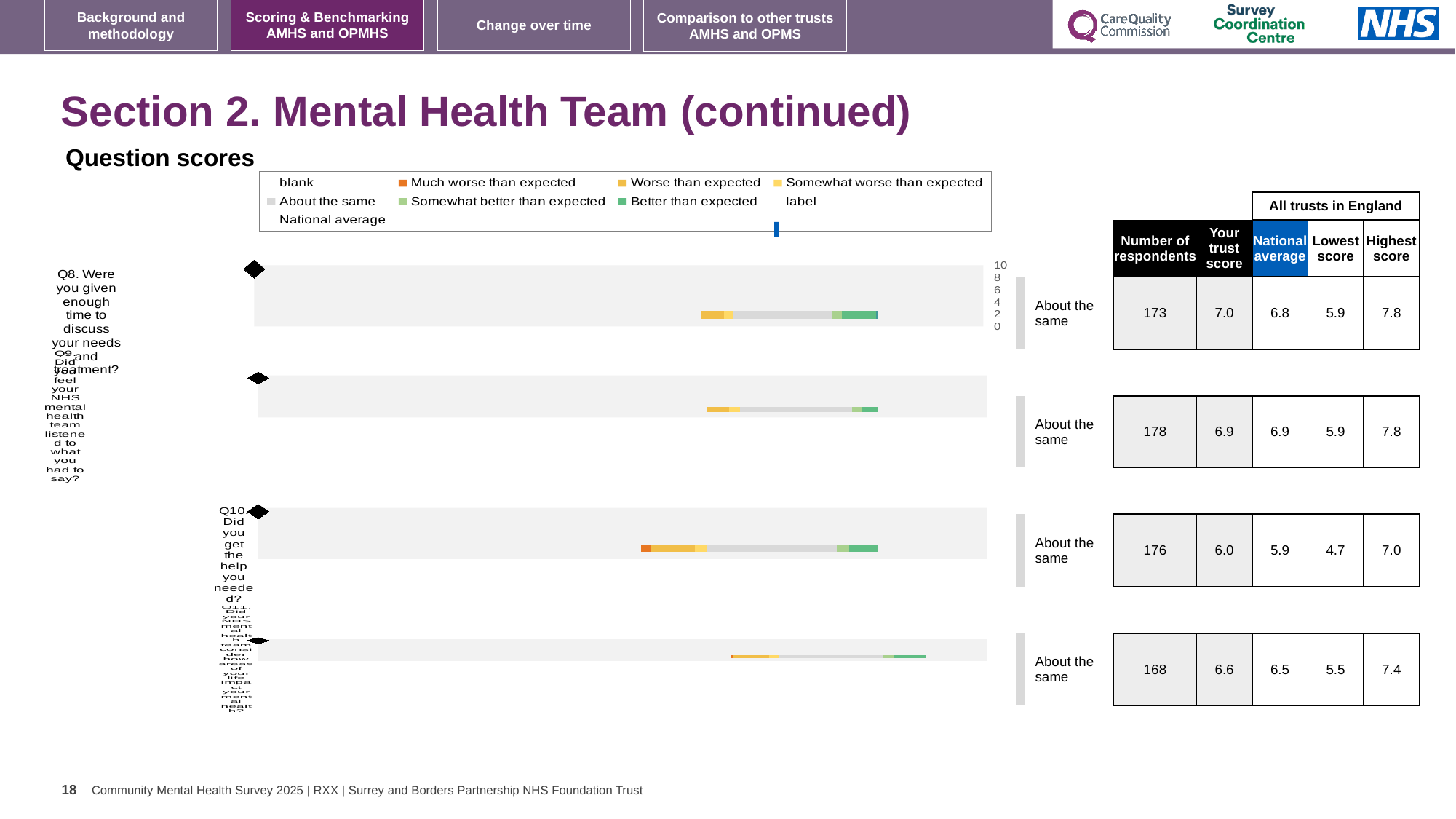
What is the highest score across all trusts in England shown for Q11? 7.4 What is the 'Your trust score' shown for Q8 (Were you given enough time to discuss your needs and treatment?)? 7.0 How many question bars (Q8 to Q11) are plotted on the slide? 4 Which question has the highest number of respondents? Q9 In the legend, what colour represents 'Much worse than expected'? Orange What is the difference between the highest score and the lowest score for Q8? 1.9 Which question has the lowest 'Your trust score'? Q10 What is the number of respondents shown for Q9? 178 For Q10, which is larger: the trust score or the national average? Trust score What is the national average shown for Q10 (Did you get the help you needed?)? 5.9 What kind of chart is used to show the question scores for Q8 to Q11? Bar chart In the legend, what colour represents 'Better than expected'? Green